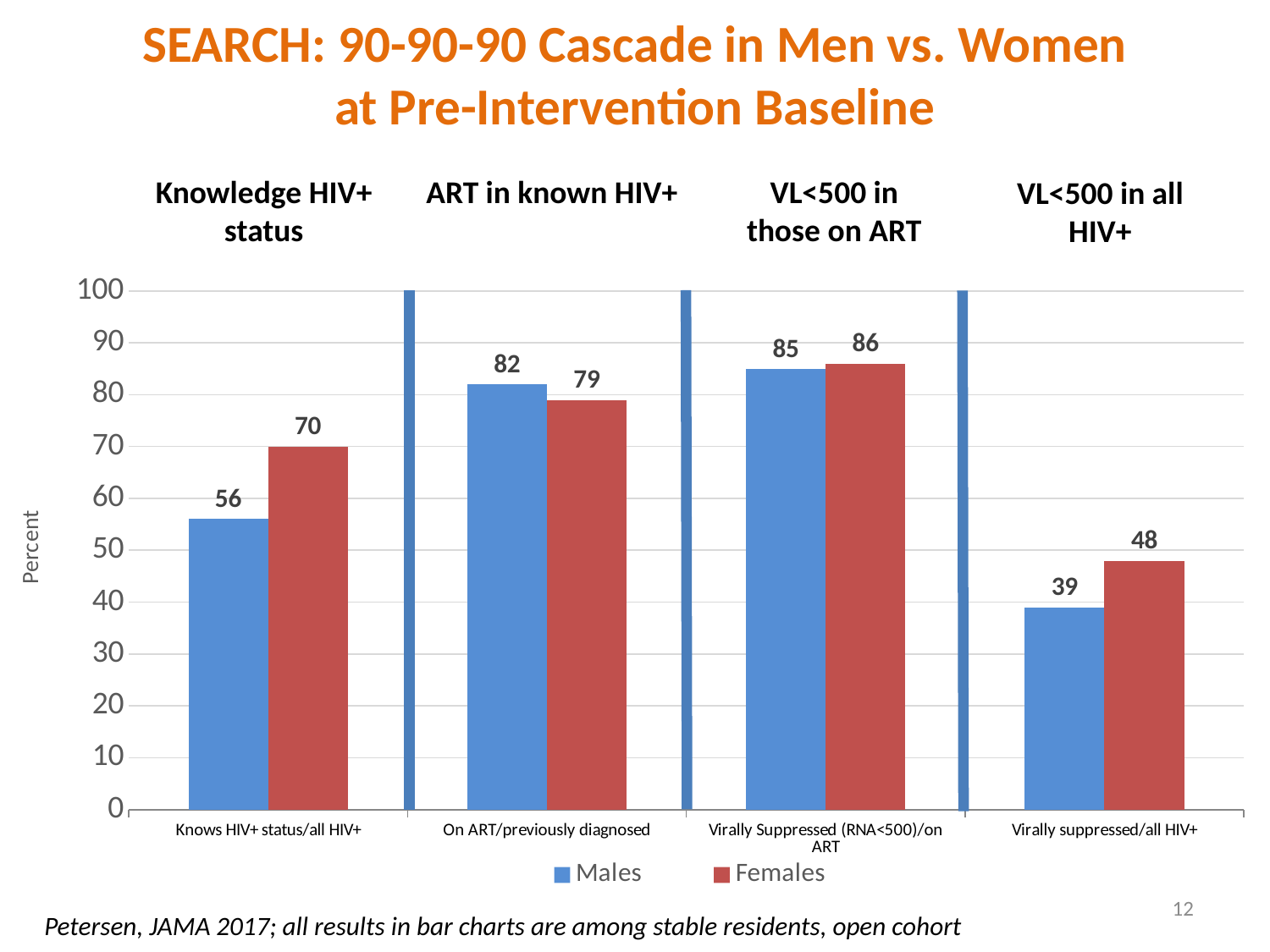
What is the difference between the Females and Males values in the 'Knows HIV+ status/all HIV+' category? 14 What kind of chart is shown on the slide? Bar chart What is the value for Females in the 'Virally suppressed/all HIV+' category? 48 In the 'On ART/previously diagnosed' category, which series has the larger value, Males or Females? Males How many categories are shown on the x axis of the chart? 4 In the 'Virally suppressed/all HIV+' category, which series has the larger value, Males or Females? Females What is the difference between the Males and Females values in the 'On ART/previously diagnosed' category? 3 What is the value for Females in the 'On ART/previously diagnosed' category? 79 How many series does the legend list? 2 What is the value for Males in the 'Knows HIV+ status/all HIV+' category? 56 Which category has the highest value for Females? Virally Suppressed (RNA<500)/on ART Which category has the lowest value for Males? Virally suppressed/all HIV+